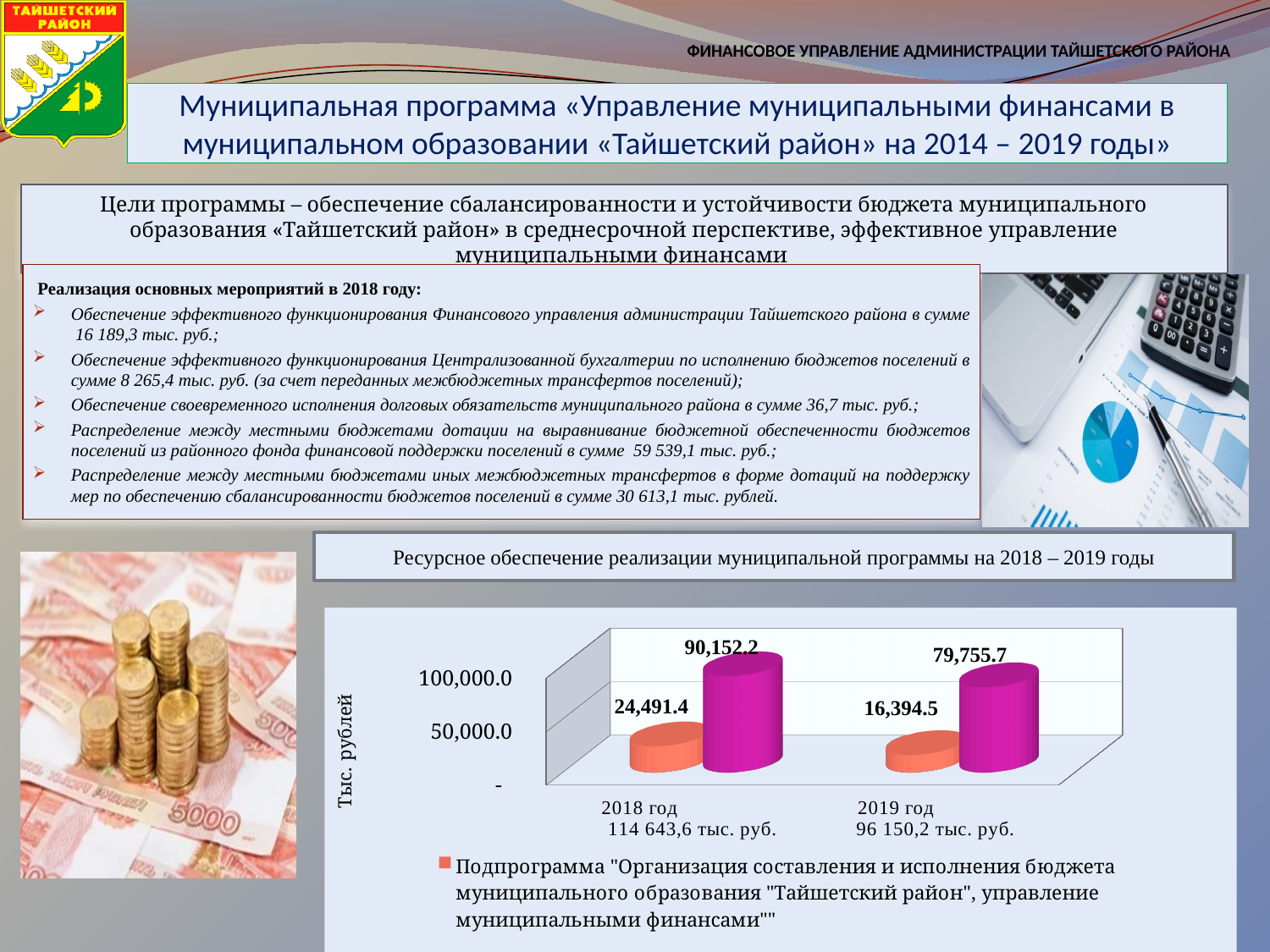
Do the bar values rise or fall from 2018 год to 2019 год? fall What total amount is printed under the 2018 год category label? 114 643,6 тыс. руб. What is the label on the vertical axis of the chart? Тыс. рублей Which year has the larger magenta bar, 2018 год or 2019 год? 2018 год What is the value of the orange bar for 2018 год? 24,491.4 What is the value of the magenta bar for 2019 год? 79,755.7 What is the value of the magenta bar for 2018 год? 90,152.2 What is the difference between the orange bar values for 2018 год and 2019 год? 8,096.9 What is the value of the orange bar for 2019 год? 16,394.5 By how much does the magenta bar for 2018 год exceed the magenta bar for 2019 год? 10,396.5 What kind of chart is shown under the heading «Ресурсное обеспечение реализации муниципальной программы на 2018 – 2019 годы»? bar chart How many year categories are shown on the x axis of the chart? 2